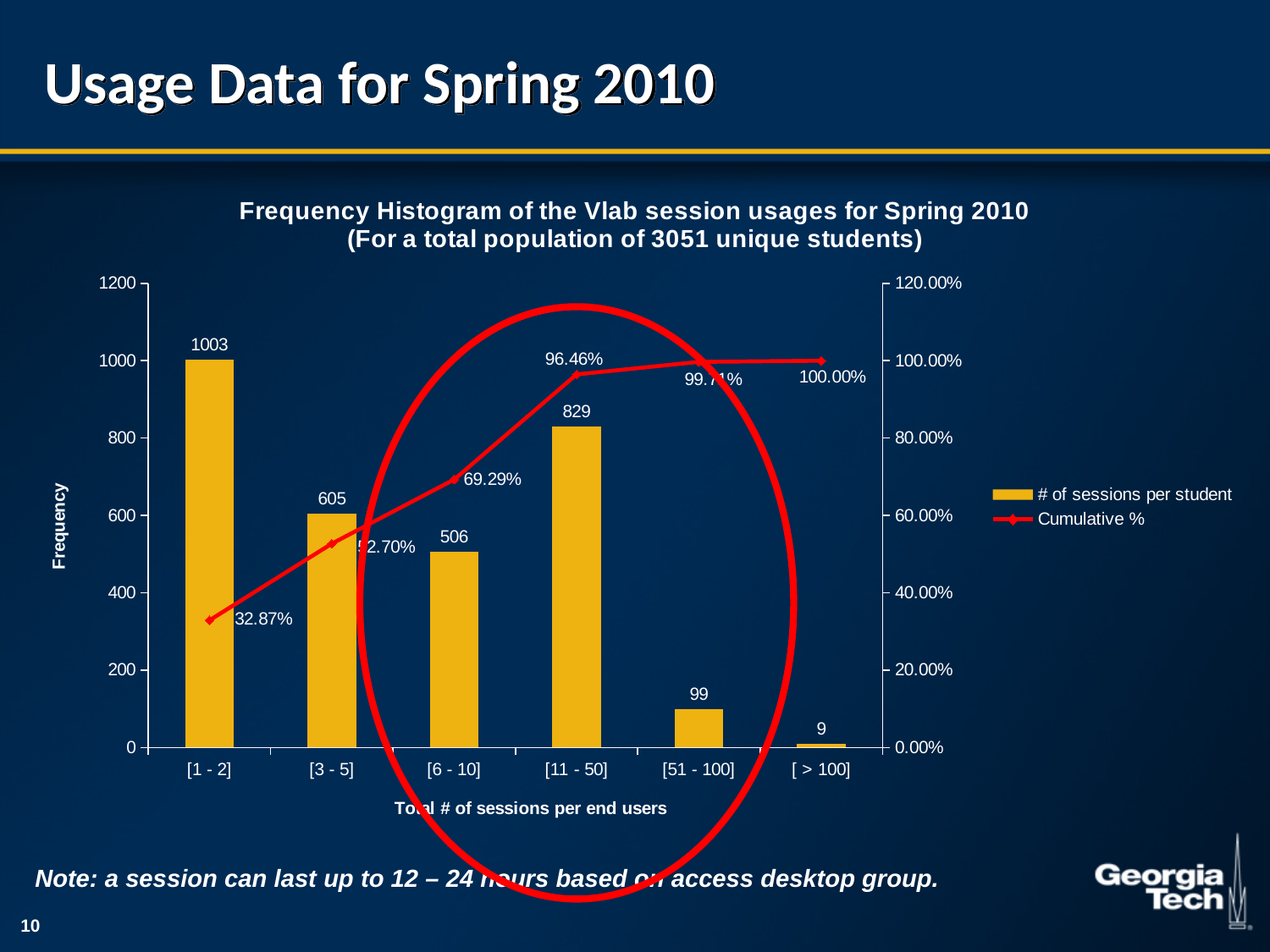
Which category has the lowest frequency? [ > 100] What is the frequency for the [11 - 50] sessions category? 829 What is the label of the left vertical axis? Frequency What is the frequency for the [ > 100] sessions category? 9 How many series does the legend list? 2 What is the difference in frequency between the [1 - 2] and [3 - 5] categories? 398 How many categories are shown on the x axis? 6 What is the Cumulative % value at the [1 - 2] category? 32.87% Which category has the highest frequency? [1 - 2] What is the Cumulative % value at the [6 - 10] category? 69.29% What is the frequency for the [1 - 2] sessions category? 1003 Which has a higher frequency, [3 - 5] or [6 - 10]? [3 - 5]